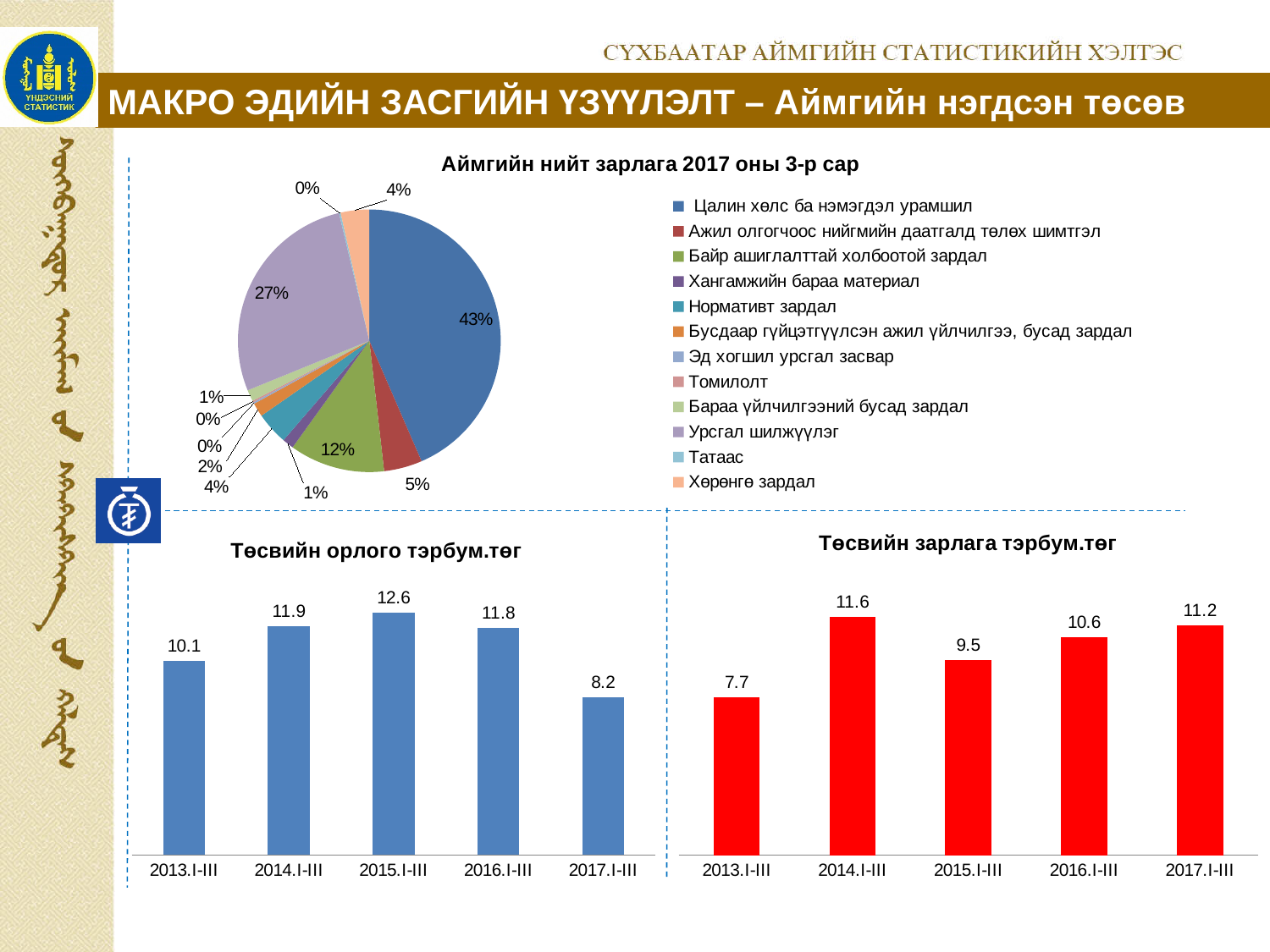
In the chart titled "Төсвийн орлого тэрбум.төг", what is the value for 2015.I-III? 12.6 In the chart titled "Төсвийн орлого тэрбум.төг", which period has the lowest value? 2017.I-III In the pie chart titled "Аймгийн нийт зарлага 2017 оны 3-р сар", what share does "Цалин хөлс ба нэмэгдэл урамшил" have? 43% In the chart titled "Төсвийн зарлага тэрбум.төг", which period has the highest value? 2014.I-III In the chart titled "Төсвийн зарлага тэрбум.төг", how many periods are shown on the x axis? 5 In the chart titled "Төсвийн зарлага тэрбум.төг", what colour are the bars? Red In the chart titled "Төсвийн зарлага тэрбум.төг", which is larger, the value for 2016.I-III or 2017.I-III? 2017.I-III In the chart titled "Төсвийн зарлага тэрбум.төг", what is the value for 2013.I-III? 7.7 In the pie chart titled "Аймгийн нийт зарлага 2017 оны 3-р сар", what share does "Урсгал шилжүүлэг" have? 27% In the chart titled "Төсвийн орлого тэрбум.төг", what is the difference between the values for 2015.I-III and 2017.I-III? 4.4 In the pie chart titled "Аймгийн нийт зарлага 2017 оны 3-р сар", how many entries does the legend list? 12 What kind of chart is the one titled "Төсвийн орлого тэрбум.төг"? Bar chart